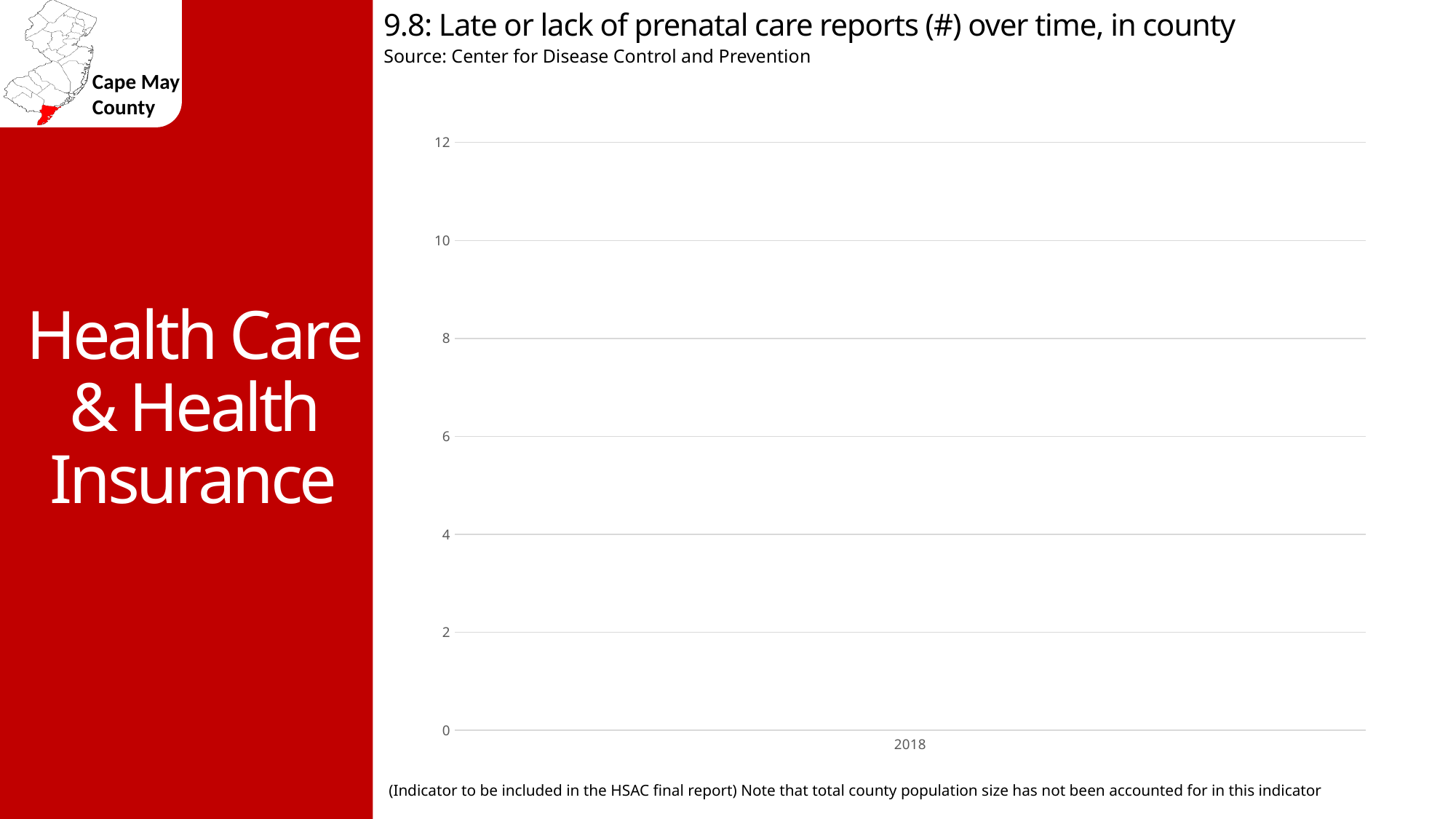
How many categories are labelled on the x axis of the chart? 1 What source is cited for the chart? Center for Disease Control and Prevention What is the title of the chart on the slide? 9.8: Late or lack of prenatal care reports (#) over time, in county Which year is labelled on the x axis of the chart? 2018